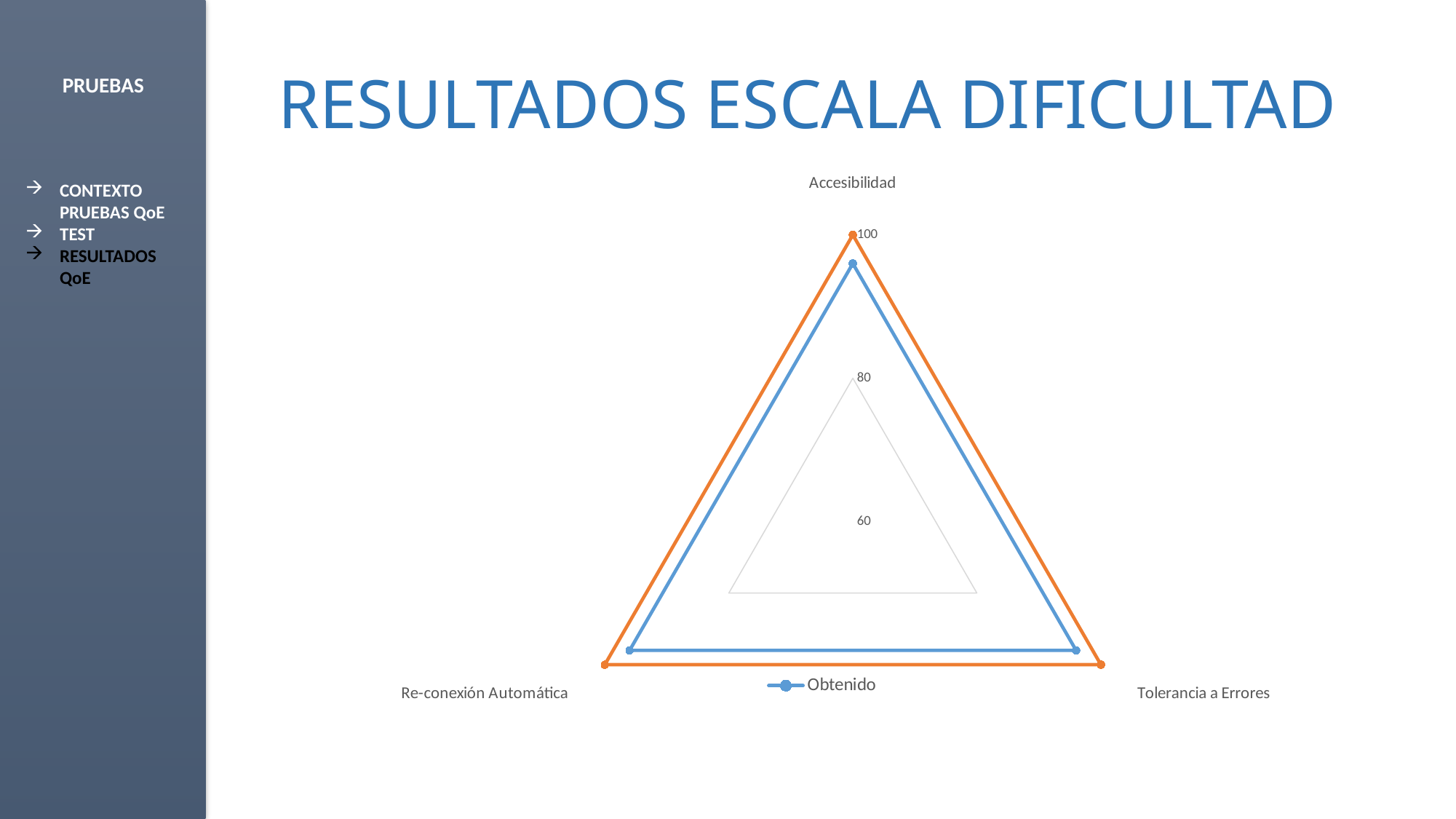
How many series does the chart legend list? 1 Is the Obtenido value for Re-conexión Automática greater or less than 80? greater What is the title of the chart slide? RESULTADOS ESCALA DIFICULTAD Is the Obtenido value for Tolerancia a Errores greater or less than 60? greater What kind of chart is shown on the slide? radar chart Is the Obtenido value for Tolerancia a Errores greater or less than 80? greater What series name appears in the chart legend? Obtenido How many categories (axes) does the radar chart have? 3